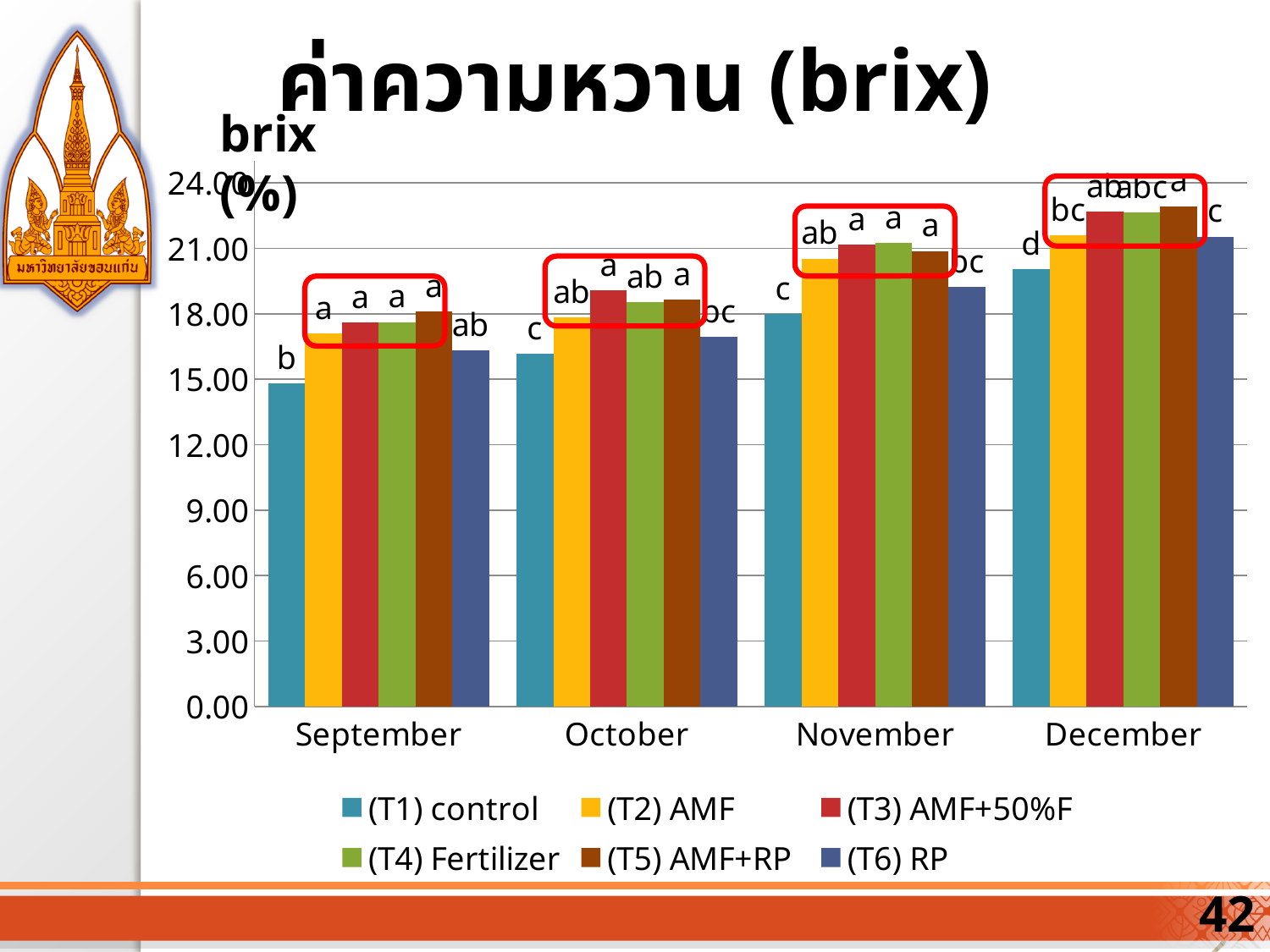
Is the value for (T1) control in October greater or less than 18.00? less Is the value for (T3) AMF+50%F in October greater or less than 18.00? greater Which treatment has the lowest value in September? (T1) control How many months are shown along the x axis of the chart? 4 Which treatment has the lowest value in December? (T1) control Which legend entry is shown in yellow? (T2) AMF Is the value for (T5) AMF+RP in December greater or less than 21.00? greater In September, which is larger: the value for (T1) control or the value for (T6) RP? (T6) RP Does the value for (T1) control rise or fall from September to December? rise How many series does the chart's legend list? 6 What kind of chart is shown on the slide? bar chart